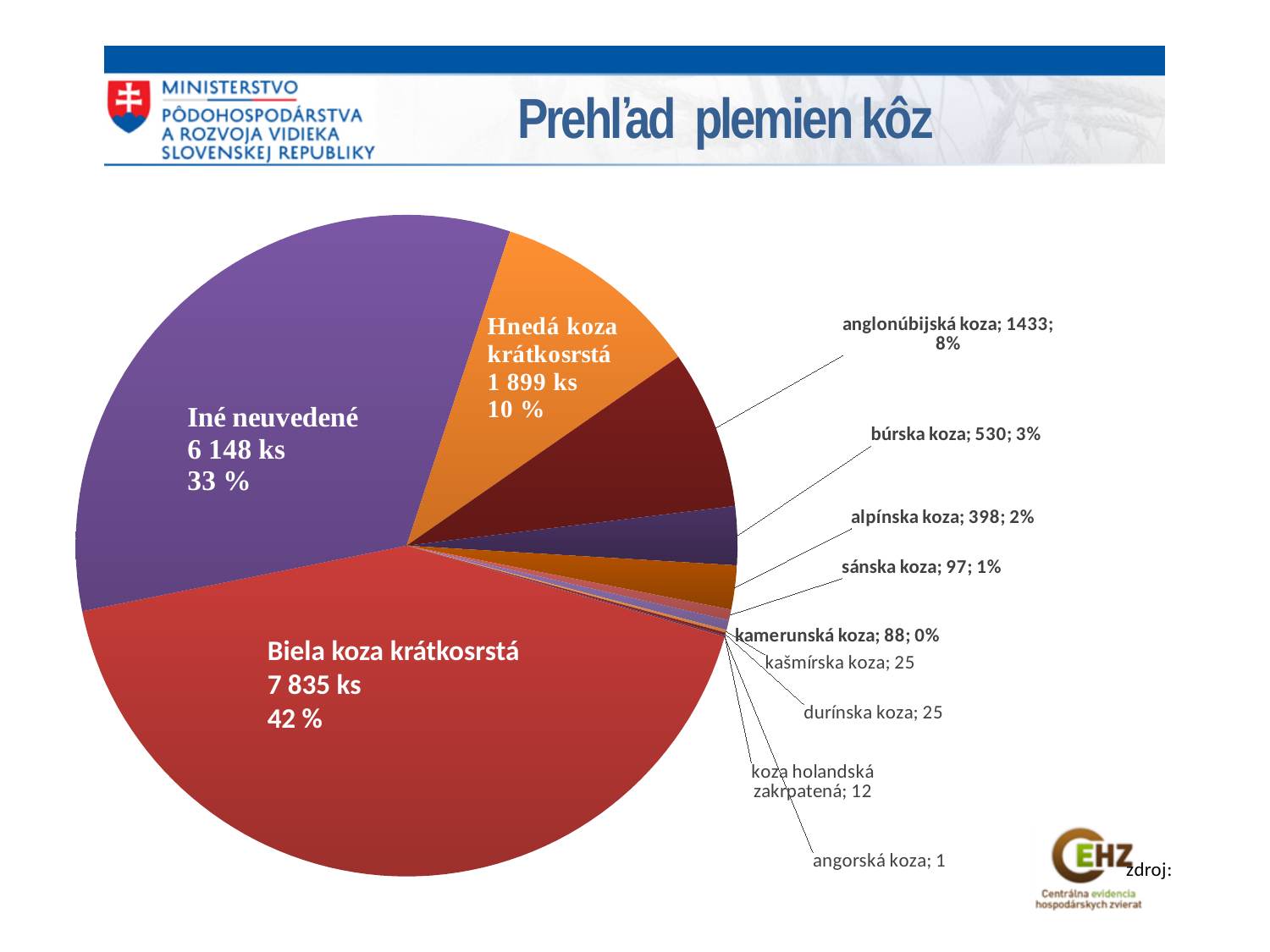
What share of the pie does Iné neuvedené represent? 33 % What is the value shown for koza holandská zakrpatená? 12 Which category has the largest slice of the pie? Biela koza krátkosrstá What is the title of the chart on the slide? Prehľad plemien kôz How many goat breed categories are shown in the pie chart? 12 What kind of chart is shown on the slide? pie chart What is the value shown for anglonúbijská koza? 1433 Which is larger, the value for alpínska koza or the value for sánska koza? alpínska koza What is the value shown for búrska koza? 530 What is the difference between the values for Biela koza krátkosrstá and Iné neuvedené? 1 687 ks What is the value shown for Biela koza krátkosrstá? 7 835 ks Which category has the smallest value in the pie chart? angorská koza